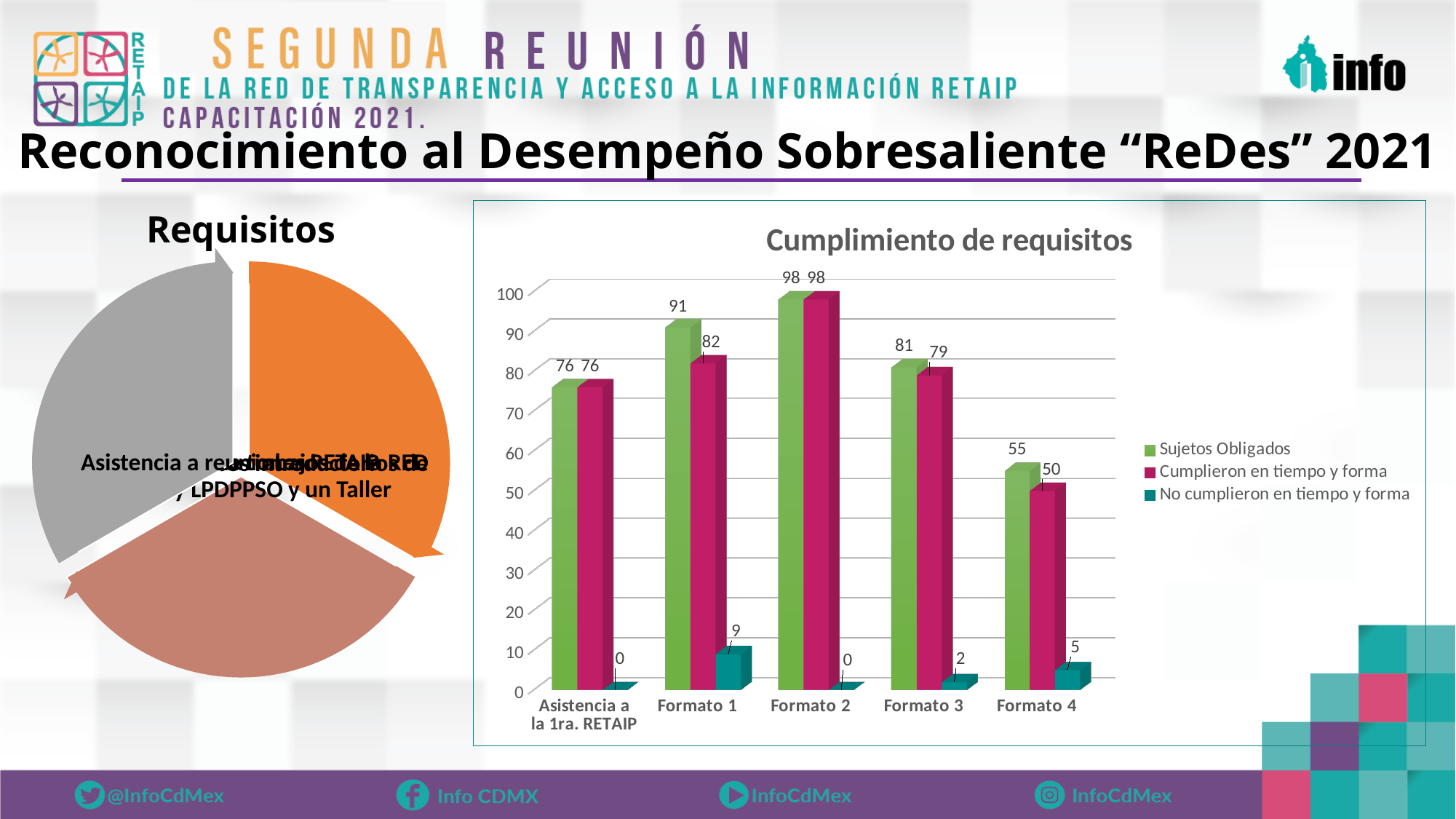
In the 'Cumplimiento de requisitos' chart, is the 'Sujetos Obligados' value for Formato 4 greater or less than 60? less In the 'Cumplimiento de requisitos' chart, which is larger: 'No cumplieron en tiempo y forma' for Formato 1 or for Formato 4? Formato 1 How many categories are shown on the x axis of the 'Cumplimiento de requisitos' chart? 5 In the 'Cumplimiento de requisitos' chart, what is the value of 'Sujetos Obligados' for Formato 1? 91 In the 'Cumplimiento de requisitos' chart, which category has the lowest 'Cumplieron en tiempo y forma' value? Formato 4 In the 'Cumplimiento de requisitos' chart, how many 'Cumplieron en tiempo y forma' are shown for Formato 4? 50 In the 'Cumplimiento de requisitos' chart, what is the 'No cumplieron en tiempo y forma' value for Formato 3? 2 How many series does the legend of the 'Cumplimiento de requisitos' chart list? 3 In the 'Cumplimiento de requisitos' chart, which legend entry is shown in green? Sujetos Obligados What kind of chart is 'Cumplimiento de requisitos'? bar chart In the 'Cumplimiento de requisitos' chart, what is the difference between 'Sujetos Obligados' and 'Cumplieron en tiempo y forma' for Formato 1? 9 In the 'Cumplimiento de requisitos' chart, which category has the highest 'Sujetos Obligados' value? Formato 2